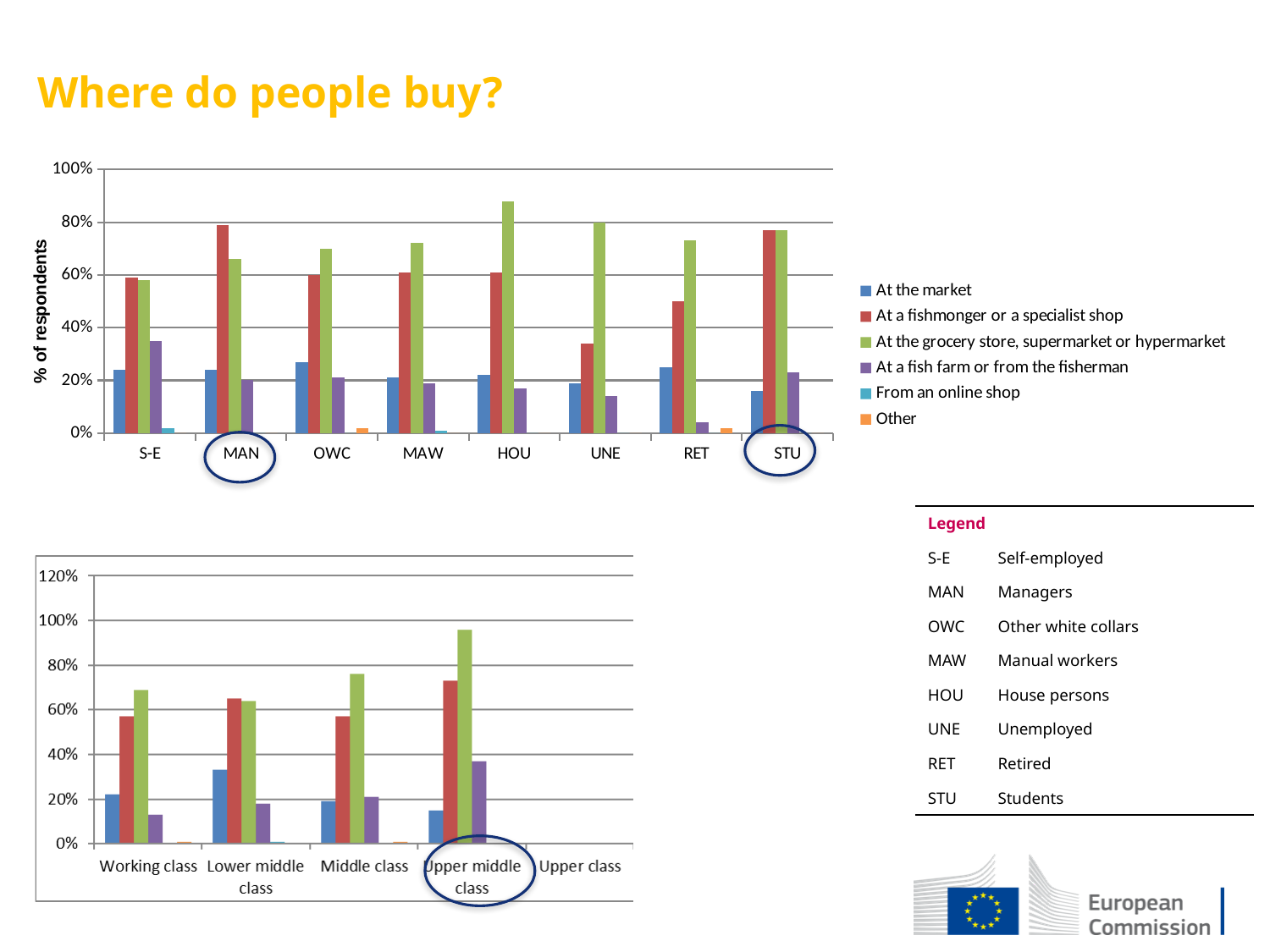
In the bottom chart, which category has the highest green bar? Upper middle class In the top chart, is the value for 'At the market' for STU greater or less than 20%? less What kind of chart is the top chart on the slide? bar chart In the bottom chart, is the green bar for Upper middle class greater or less than 80%? greater In the top chart, which category has the highest value for 'At the grocery store, supermarket or hypermarket'? HOU What is the label on the y axis of the top chart? % of respondents In the top chart, for HOU, which is larger: 'At a fishmonger or a specialist shop' or 'At the grocery store, supermarket or hypermarket'? At the grocery store, supermarket or hypermarket In the top chart, how many series does the legend list? 6 In the top chart, how many categories are shown on the x axis? 8 In the top chart, which category has the lowest value for 'At a fishmonger or a specialist shop'? UNE In the bottom chart, how many categories are shown on the x axis? 5 In the top chart, is the value for 'At a fishmonger or a specialist shop' for MAN greater or less than 60%? greater